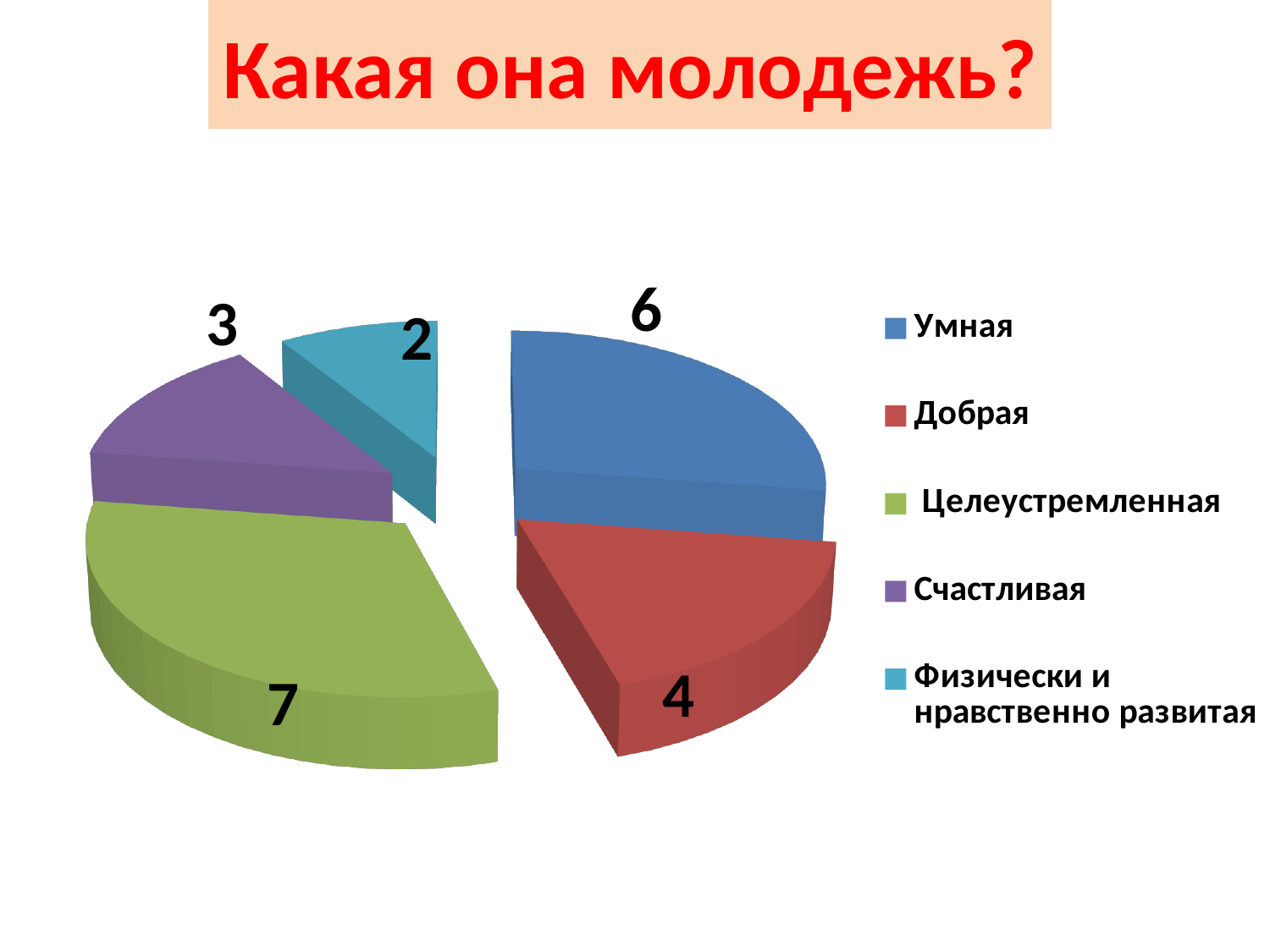
Which category has the largest slice? Целеустремленная What is the difference between the values for Целеустремленная and Добрая? 3 Which is larger, the value for Умная or the value for Счастливая? Умная What is the value for Целеустремленная? 7 What kind of chart is shown on the slide? pie chart What is the value for Физически и нравственно развитая? 2 What is the title of the slide containing the chart? Какая она молодежь? Which category has the smallest slice? Физически и нравственно развитая How many categories does the pie chart have? 5 What is the value for Умная? 6 What is the value for Счастливая? 3 What is the value for Добрая? 4